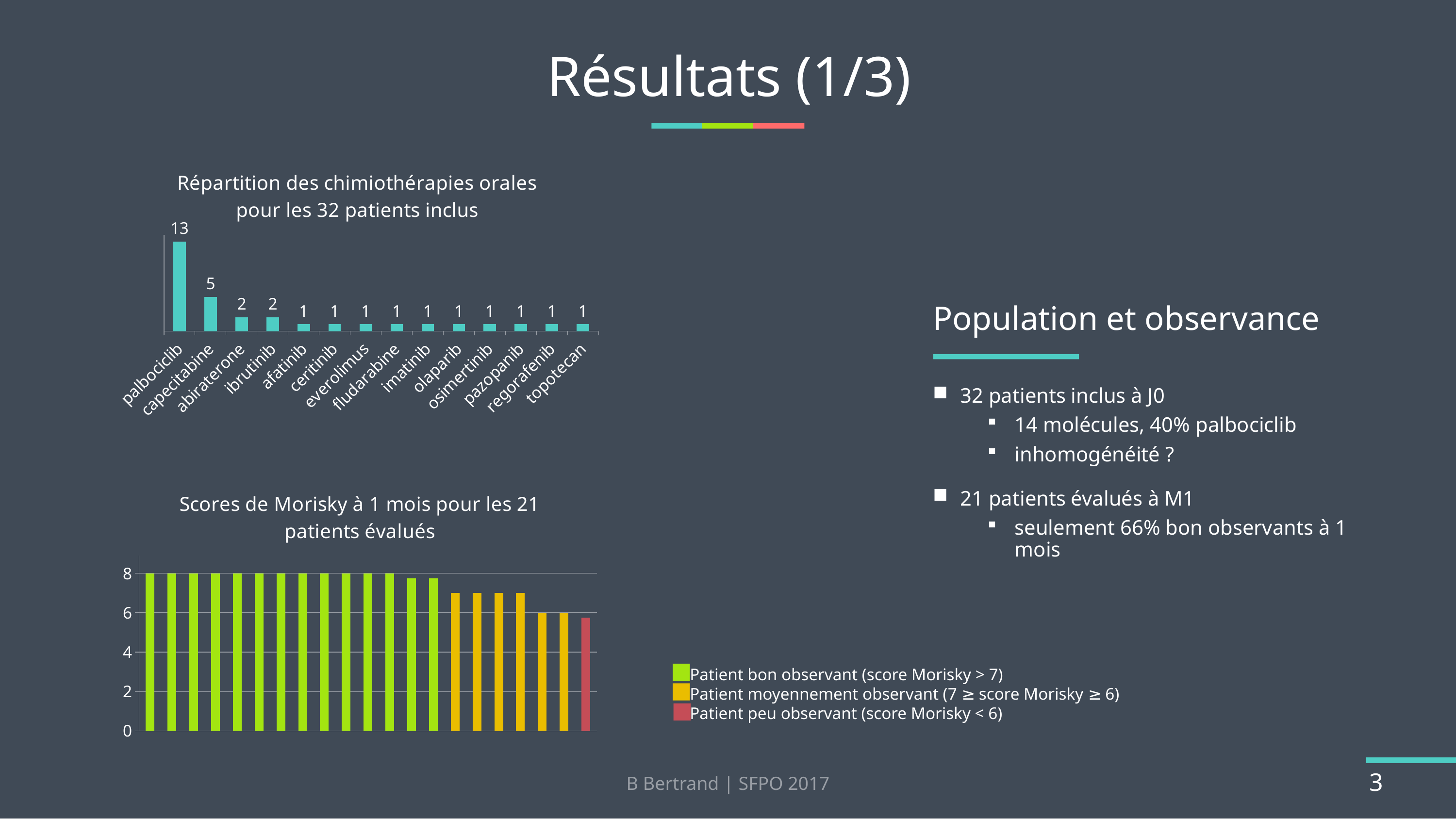
In the chart 'Répartition des chimiothérapies orales pour les 32 patients inclus', what is the difference between the values for palbociclib and capecitabine? 8 In the chart 'Répartition des chimiothérapies orales pour les 32 patients inclus', which has the larger value, abiraterone or afatinib? abiraterone What kind of chart is 'Répartition des chimiothérapies orales pour les 32 patients inclus'? bar chart In the chart 'Scores de Morisky à 1 mois pour les 21 patients évalués', what colour represents 'Patient peu observant (score Morisky < 6)'? red In the chart 'Répartition des chimiothérapies orales pour les 32 patients inclus', what is the value for ibrutinib? 2 In the chart 'Répartition des chimiothérapies orales pour les 32 patients inclus', which molecule has the highest value? palbociclib In the chart 'Répartition des chimiothérapies orales pour les 32 patients inclus', how many molecules are shown on the x axis? 14 In the chart 'Répartition des chimiothérapies orales pour les 32 patients inclus', what is the value for capecitabine? 5 In the chart 'Répartition des chimiothérapies orales pour les 32 patients inclus', what is the value for palbociclib? 13 What kind of chart is 'Scores de Morisky à 1 mois pour les 21 patients évalués'? bar chart In the chart 'Scores de Morisky à 1 mois pour les 21 patients évalués', is the value of the first (leftmost) bar greater or less than 4? greater In the chart 'Scores de Morisky à 1 mois pour les 21 patients évalués', how many entries does the legend list? 3